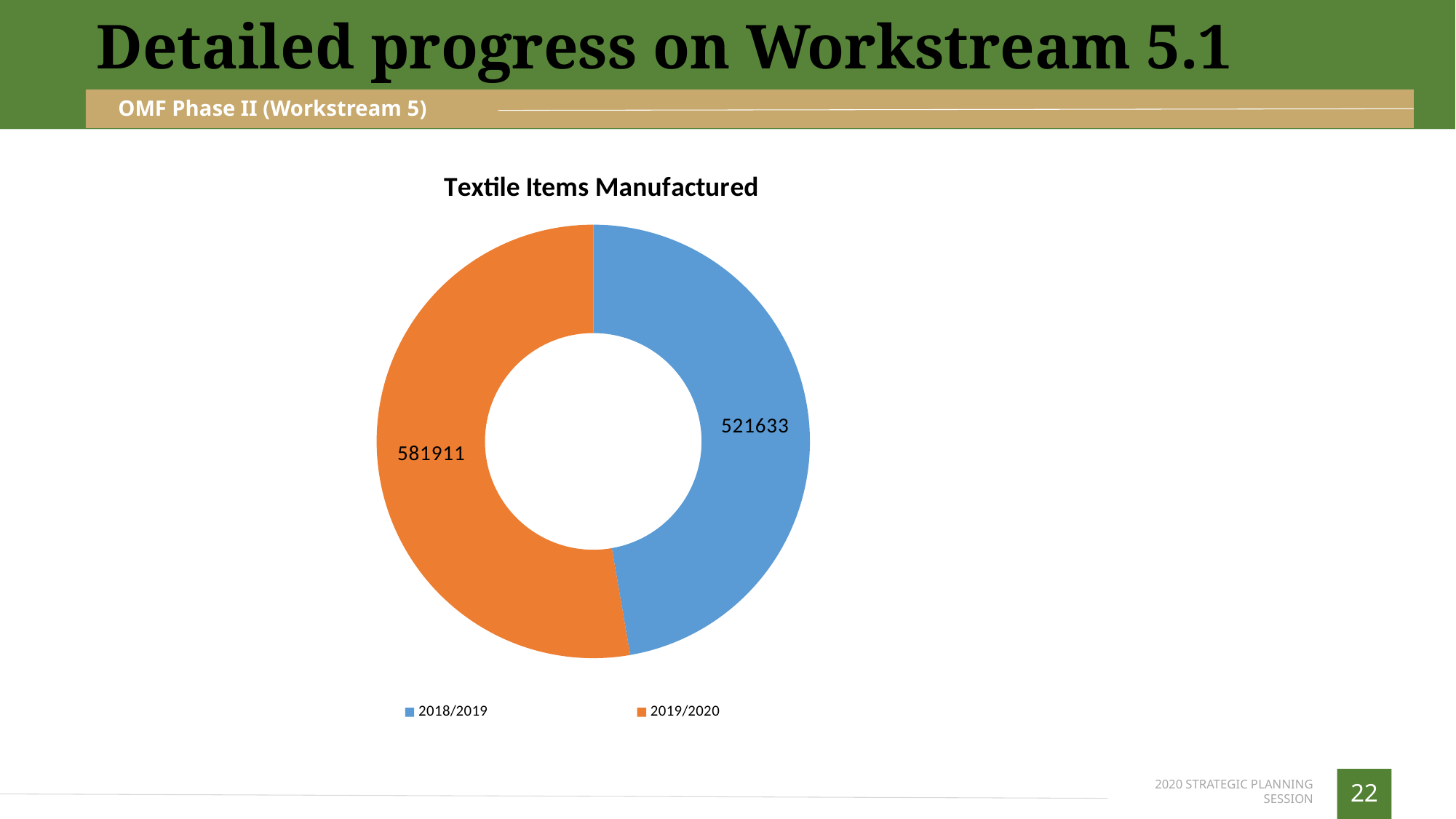
Which is larger in the Textile Items Manufactured chart: 2018/2019 or 2019/2020? 2019/2020 What is the total of the two values shown in the Textile Items Manufactured chart? 1103544 What is the value for 2019/2020 in the Textile Items Manufactured chart? 581911 How many entries does the legend of the Textile Items Manufactured chart list? 2 Which colour represents 2018/2019 in the Textile Items Manufactured chart? blue What share of the total does the 2019/2020 slice represent in the Textile Items Manufactured chart, to one decimal place? 52.7% How many slices does the Textile Items Manufactured chart have? 2 Which period has the lowest number of textile items manufactured? 2018/2019 What kind of chart is used to show Textile Items Manufactured? doughnut chart What is the value for 2018/2019 in the Textile Items Manufactured chart? 521633 Which period has the highest number of textile items manufactured? 2019/2020 What is the difference between the 2019/2020 and 2018/2019 values in the Textile Items Manufactured chart? 60278